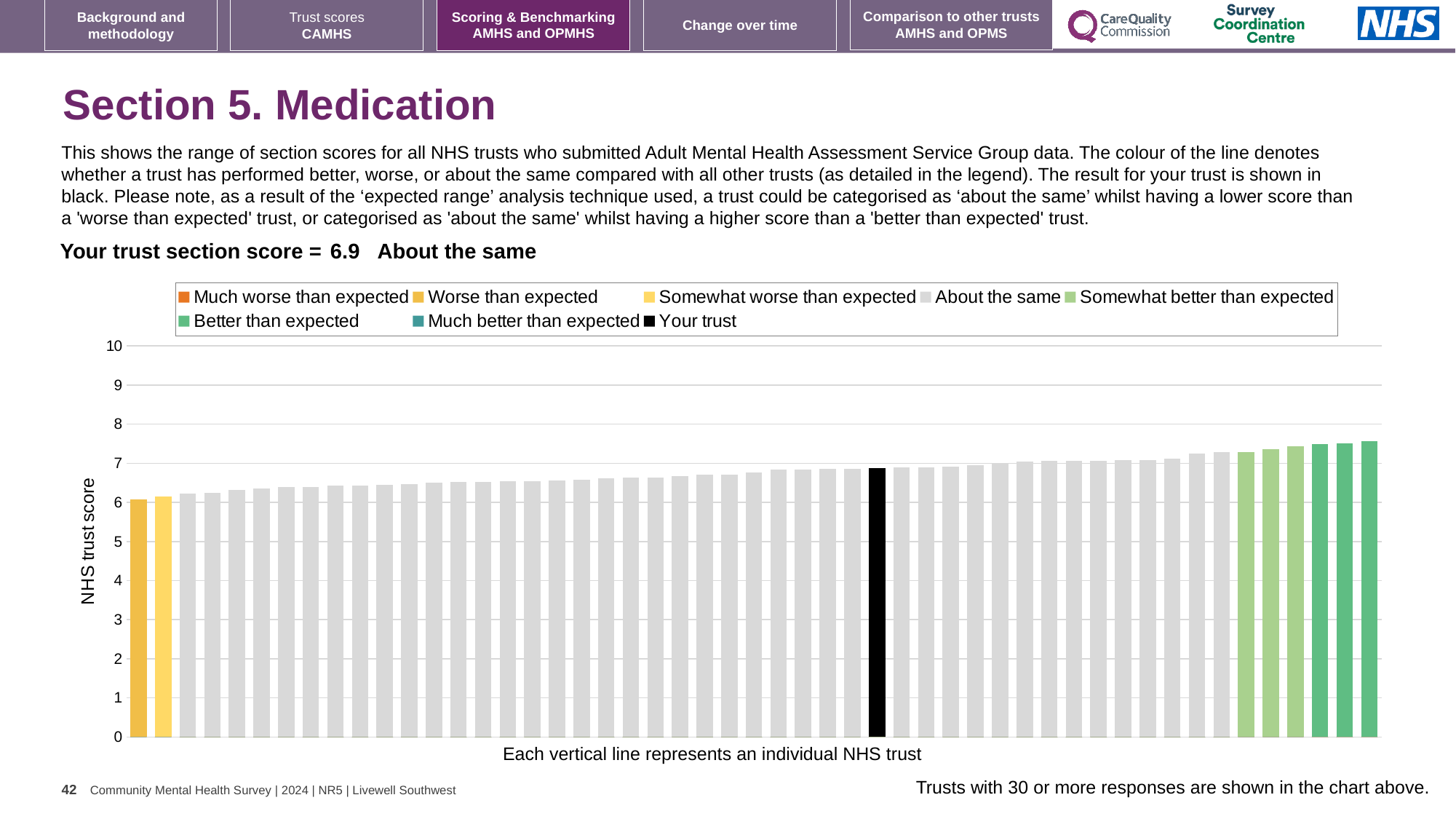
What is the label on the vertical axis of the chart? NHS trust score Is the value of the highest bar in the chart greater or less than 8? less Is the value of the lowest bar in the chart greater or less than 7? less What is the section score for your trust shown on the slide? 6.9 Do the bar values rise or fall from left to right along the x axis? rise What colour is used for the 'Your trust' bar in the chart? black What kind of chart is shown on the slide? bar chart How many entries does the chart legend list? 8 Is the value of the black 'Your trust' bar greater or less than 6? greater Which category is your trust's section score placed in, according to the slide? About the same How many bars in the chart are coloured as 'Worse than expected'? 1